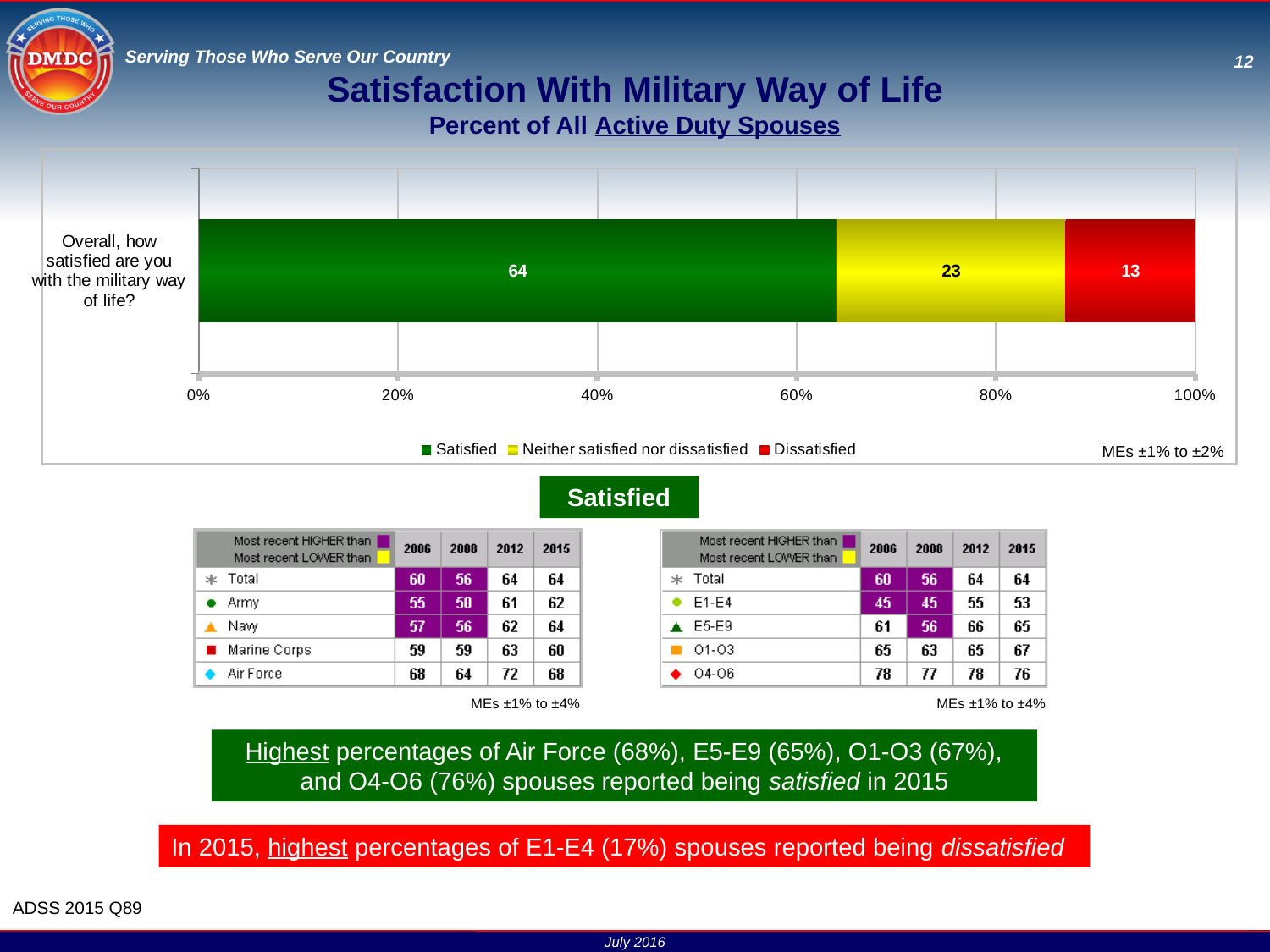
What type of chart is shown on the slide? stacked bar chart How many series does the chart legend list? 3 Which response category has the largest share of the bar? Satisfied What is the difference between the Satisfied and Dissatisfied percentages? 51 What percentage of active duty spouses are Neither satisfied nor dissatisfied? 23 Is the Satisfied value greater or less than 60%? greater What percentage of active duty spouses are Dissatisfied with the military way of life? 13 What colour represents the Dissatisfied segment in the chart? Red Which response category has the smallest share of the bar? Dissatisfied What is the total of the three segments in the stacked bar? 100 What percentage of active duty spouses are Satisfied with the military way of life? 64 Which is larger, the Neither satisfied nor dissatisfied share or the Dissatisfied share? Neither satisfied nor dissatisfied